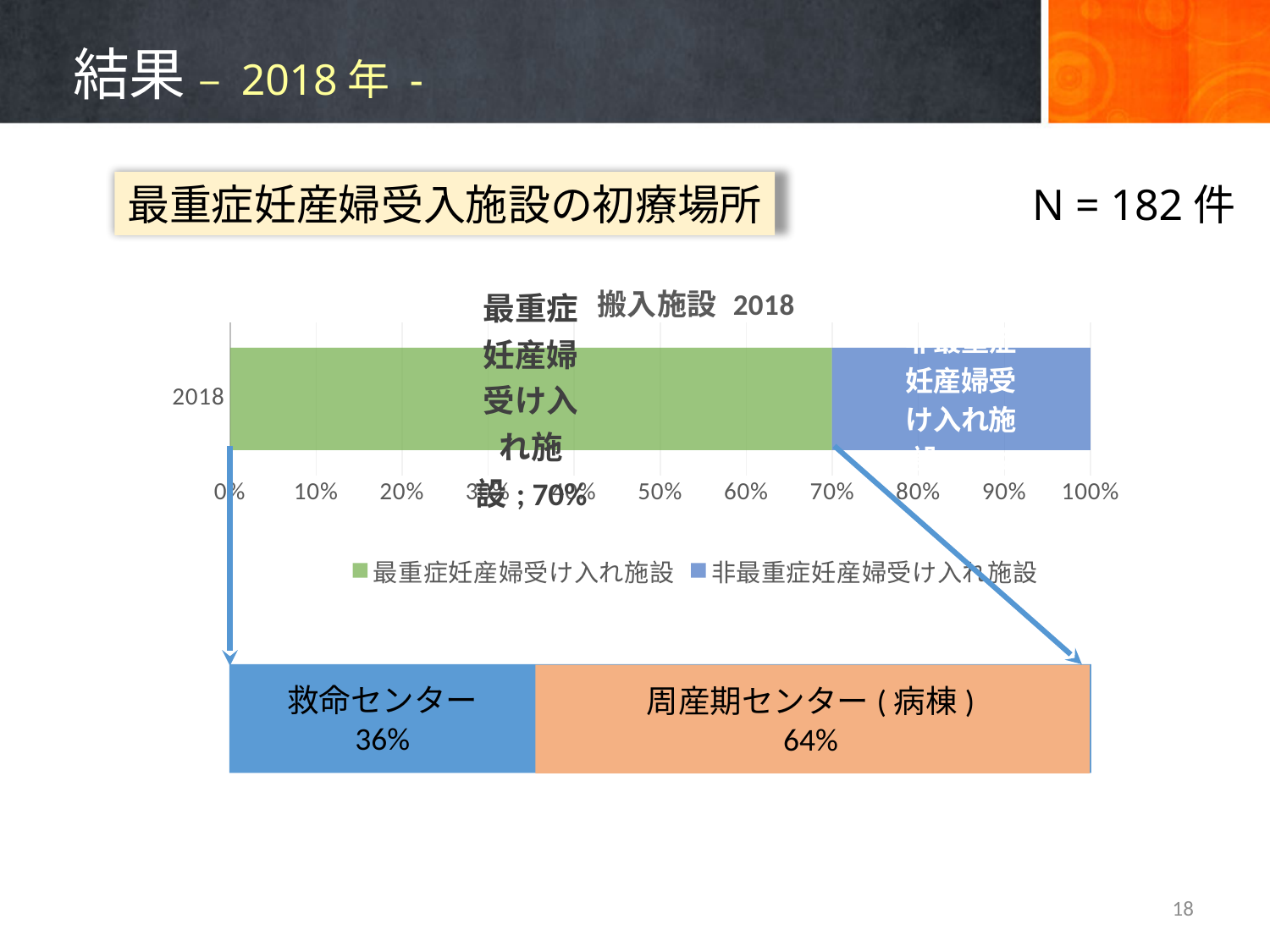
In the chart titled 搬入施設 2018, which series has the larger share of the bar, 最重症妊産婦受け入れ施設 or 非最重症妊産婦受け入れ施設? 最重症妊産婦受け入れ施設 In the chart titled 搬入施設 2018, is the value for 最重症妊産婦受け入れ施設 greater or less than 60%? greater In the lower bar at the bottom of the slide, what percentage is shown for 周産期センター(病棟)? 64% In the lower bar at the bottom of the slide, what is the difference between the 周産期センター(病棟) and 救命センター percentages? 28% In the chart titled 搬入施設 2018, what percentage is shown for 最重症妊産婦受け入れ施設? 70% How many series does the legend of the chart titled 搬入施設 2018 list? 2 In the chart titled 搬入施設 2018, is the value for 非最重症妊産婦受け入れ施設 greater or less than 40%? less In the lower bar at the bottom of the slide, what percentage is shown for 救命センター? 36% What is the category label on the vertical axis of the chart titled 搬入施設 2018? 2018 What kind of chart is the chart titled 搬入施設 2018? bar chart In the chart titled 搬入施設 2018, what colour is the 最重症妊産婦受け入れ施設 series? green How many categories are shown on the vertical axis of the chart titled 搬入施設 2018? 1